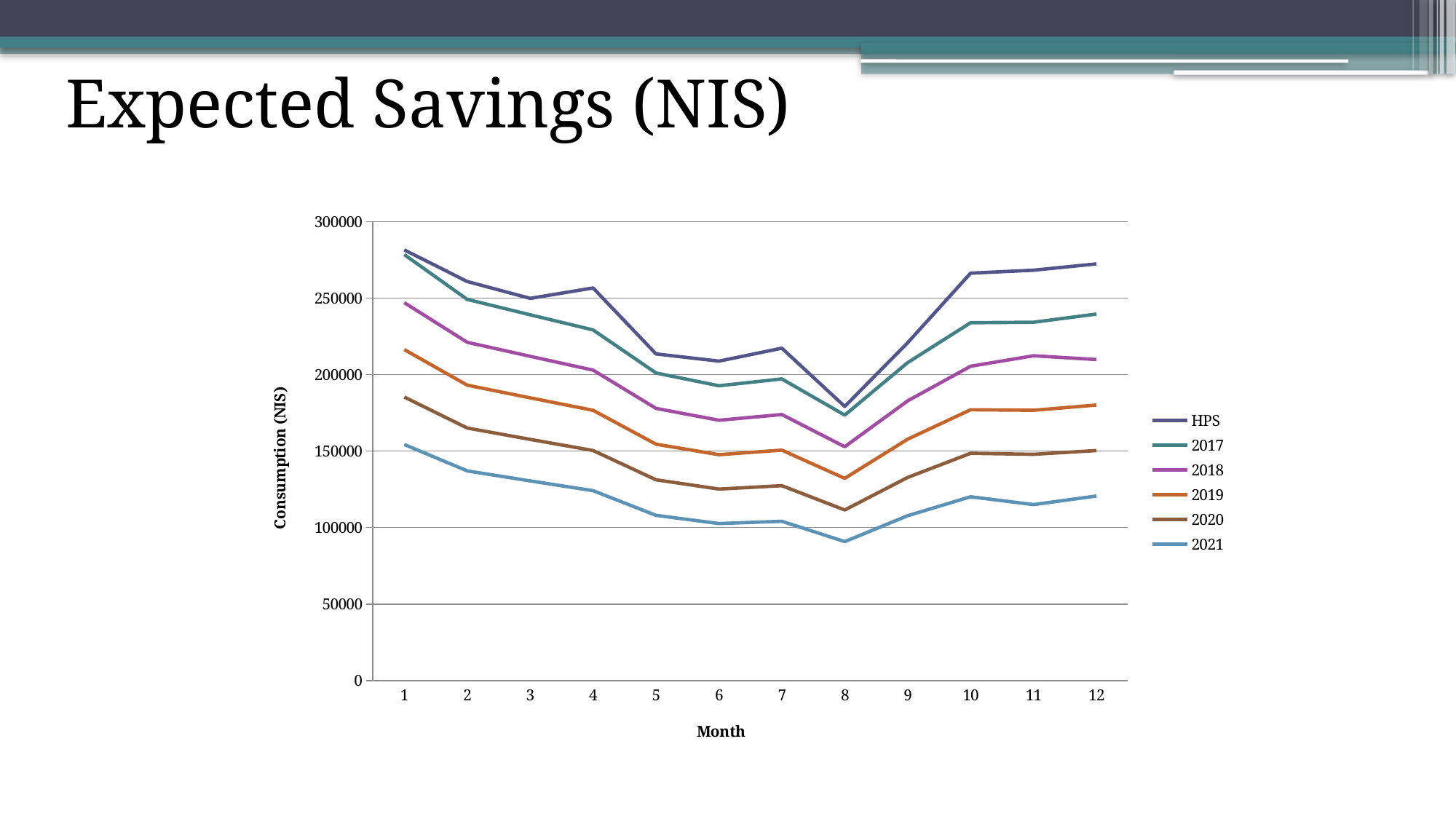
How many series does the legend list? 6 At month 12, which is larger: the value for HPS or the value for 2017? HPS Is the value for 2020 at month 1 greater or less than 150000? greater What kind of chart is shown on the slide? line chart Is the value for 2019 at month 8 greater or less than 150000? less At which month does the 2021 series reach its lowest value? 8 Which series has the highest value at month 12? HPS Which series has the lowest value at month 1? 2021 Is the value for 2021 at month 8 greater or less than 100000? less Does the 2020 series rise or fall from month 1 to month 8? fall How many months are plotted along the x axis? 12